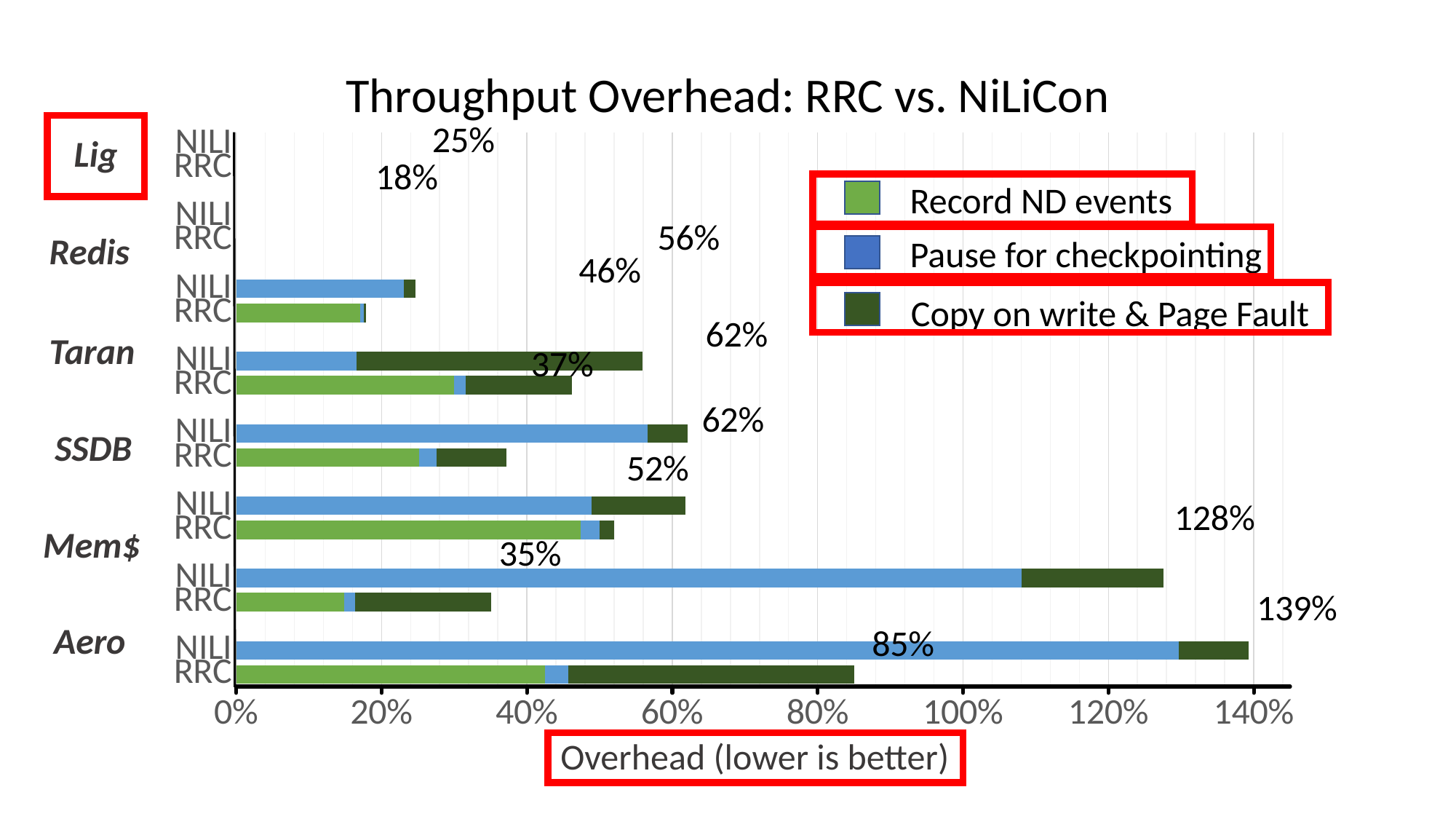
Is the value for the Aero NILI bar greater or less than 120%? greater What is the difference between the Aero NILI overhead and the Aero RRC overhead? 54% What is the lowest overhead value labelled on the chart? 18% How many application categories are labelled on the vertical axis? 6 What is the overhead value for the Aero NILI bar? 139% What is the overhead value for the Aero RRC bar? 85% How many series does the legend list? 3 What is the title of the chart? Throughput Overhead: RRC vs. NiLiCon What is the highest overhead value labelled on the chart? 139% What kind of chart is shown on the slide? Stacked bar chart For Aero, which has the larger overhead, NILI or RRC? NILI What is the label of the horizontal axis? Overhead (lower is better)